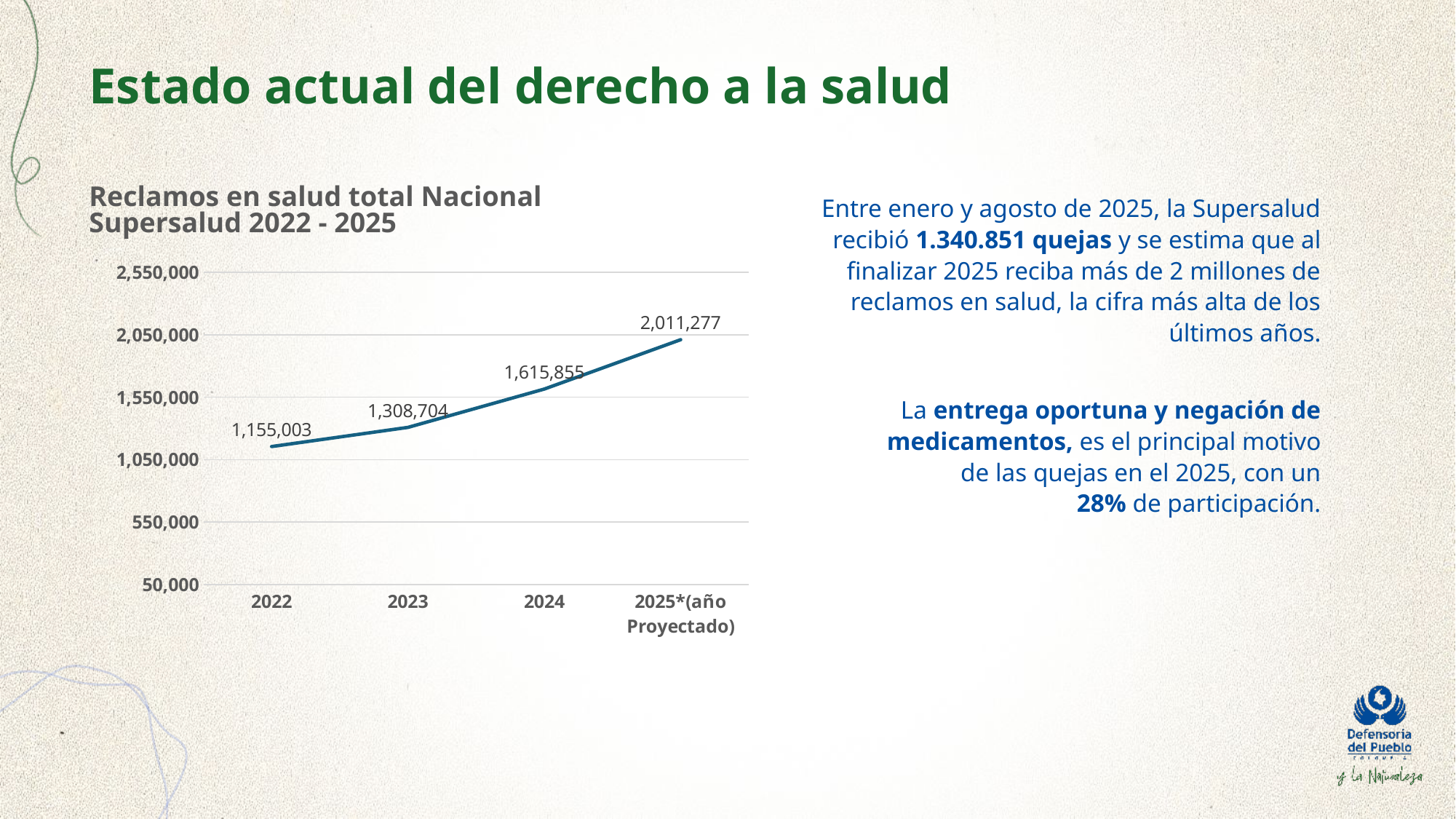
What type of chart is shown on the slide? line chart Do the values rise or fall from 2022 to 2025? rise Which year has the highest value in the chart? 2025*(año Proyectado) What is the value for 2023 in the chart? 1,308,704 How many data points are plotted on the line? 4 Which year has the lowest value in the chart? 2022 What is the value for 2024 in the chart? 1,615,855 What is the projected value for 2025 in the chart? 2,011,277 Which is larger, the value for 2023 or the value for 2024? 2024 What is the difference between the 2024 value and the 2023 value? 307,151 What is the difference between the projected 2025 value and the 2022 value? 856,274 What is the value for 2022 in the chart? 1,155,003